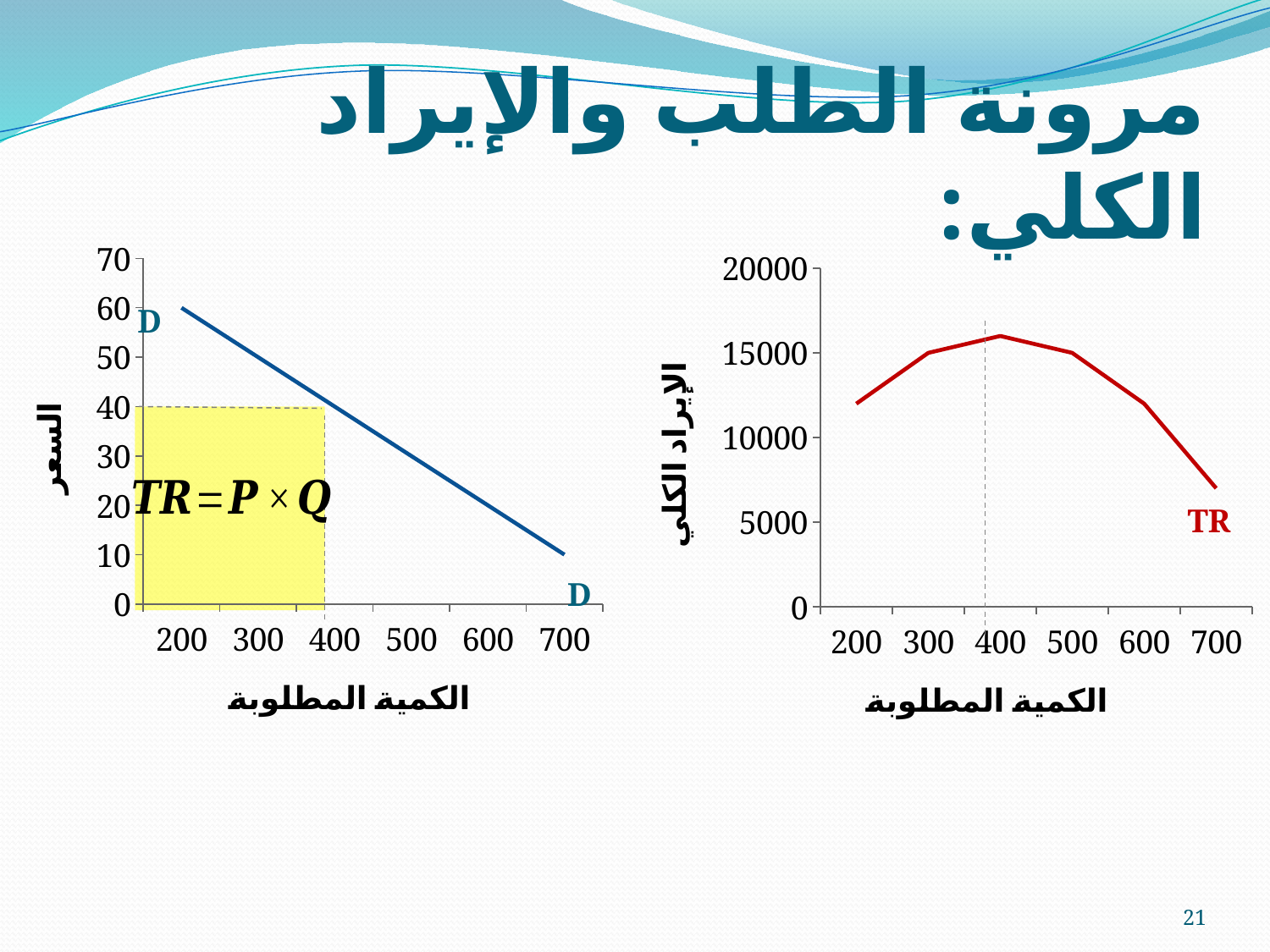
What kind of chart is the left chart (السعر vs الكمية المطلوبة)? line chart On the right chart, is the TR value at quantity 400 greater or less than 15000? greater On the left chart, what is the price (السعر) when the quantity demanded is 700? 10 On the left chart, what is the price (السعر) when the quantity demanded is 200? 60 On the right chart, at which quantity is total revenue (TR) highest? 400 On the right chart, which quantity has the larger TR value: 300 or 600? 300 What kind of chart is the right chart (الإيراد الكلي vs الكمية المطلوبة)? line chart On the right chart, is the TR value at quantity 700 greater or less than 10000? less On the right chart, at which quantity is total revenue (TR) lowest? 700 What is the x-axis label of the right chart? الكمية المطلوبة On the left chart, does the demand line D rise or fall as quantity increases along the x axis? fall On the right chart, how many quantity values are marked on the x axis? 6